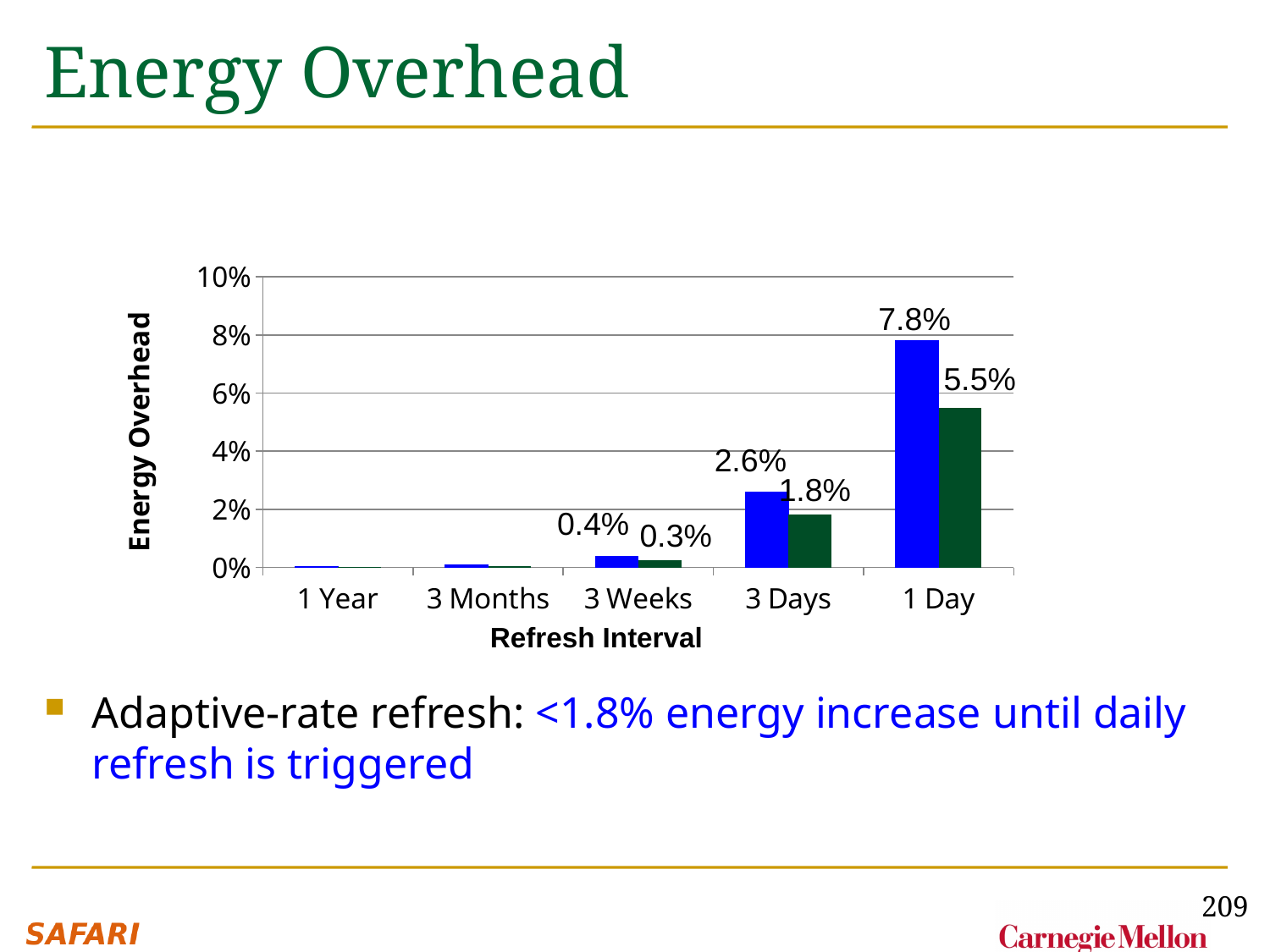
What is the difference between the blue and dark green bars for 1 Day? 2.3% What is the value of the dark green bar for 3 Weeks? 0.3% What is the label of the x axis? Refresh Interval How many refresh intervals are shown on the x axis? 5 What is the value of the blue bar for 3 Days? 2.6% Which is larger for 3 Days, the blue bar or the dark green bar? the blue bar What is the value of the blue bar for 1 Day? 7.8% What kind of chart is shown on the slide? bar chart What is the value of the dark green bar for 1 Day? 5.5% What is the difference between the blue bars for 1 Day and 3 Days? 5.2% Is the value of the dark green bar for 1 Day greater or less than 4%? greater Which refresh interval has the highest energy overhead for the blue bars? 1 Day